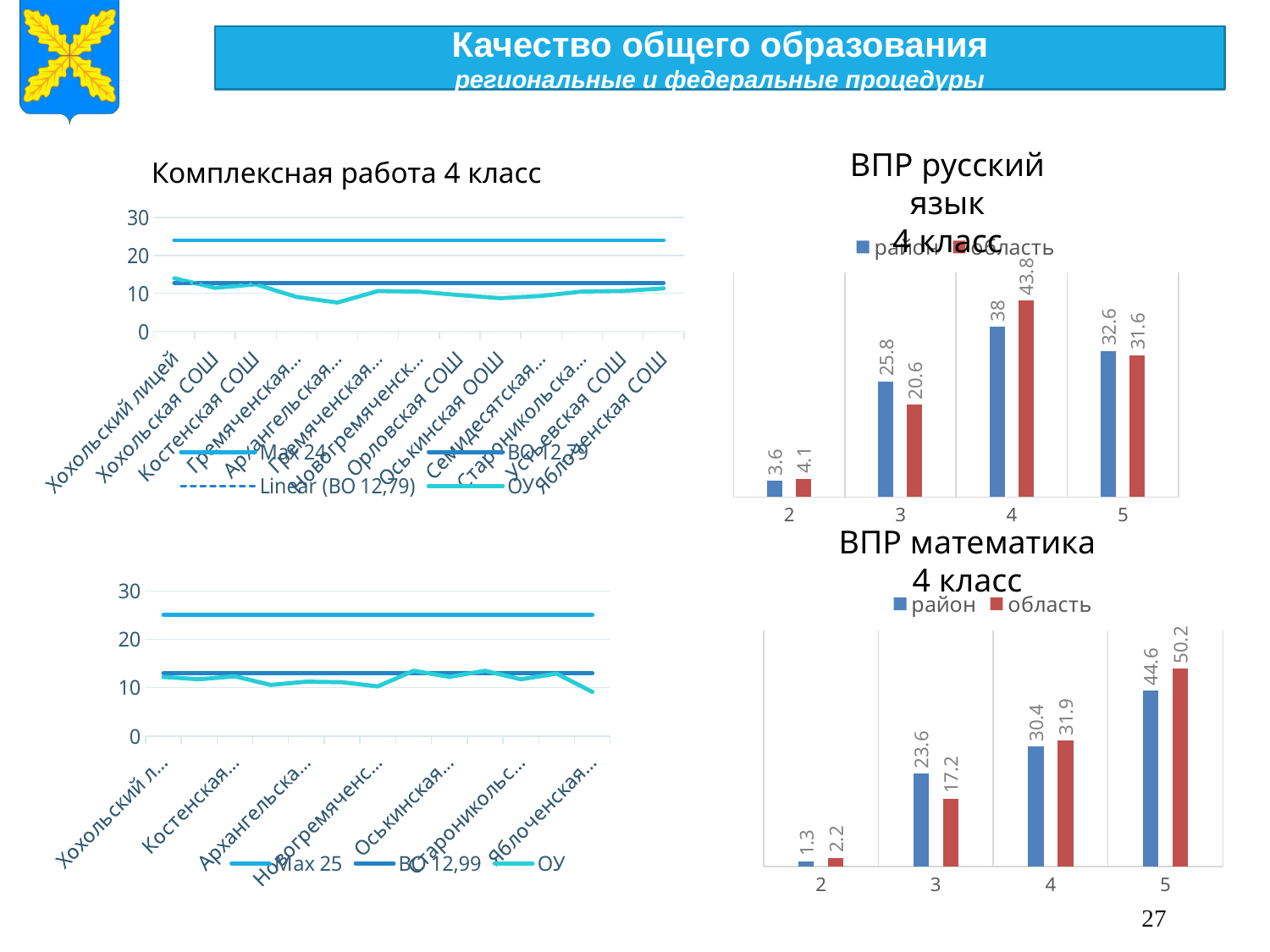
How many series does the legend of the ВПР математика 4 класс chart list? 2 On the ВПР математика 4 класс chart, what is the value for область for category 5? 50.2 On the ВПР математика 4 класс chart, what is the value for район for category 2? 1.3 What kind of chart is the top-left Комплексная работа 4 класс chart? line chart On the ВПР русский язык 4 класс chart, which category has the highest область value? 4 What kind of chart is the ВПР русский язык 4 класс chart? bar chart On the ВПР математика 4 класс chart, what is the difference between область and район for category 5? 5.6 On the ВПР русский язык 4 класс chart, what is the value for область for category 3? 20.6 On the ВПР русский язык 4 класс chart, which is larger for category 5, район or область? район On the ВПР математика 4 класс chart, which category has the lowest район value? 2 On the ВПР русский язык 4 класс chart, what is the difference between район and область for category 3? 5.2 On the ВПР русский язык 4 класс chart, what is the value for район for category 4? 38